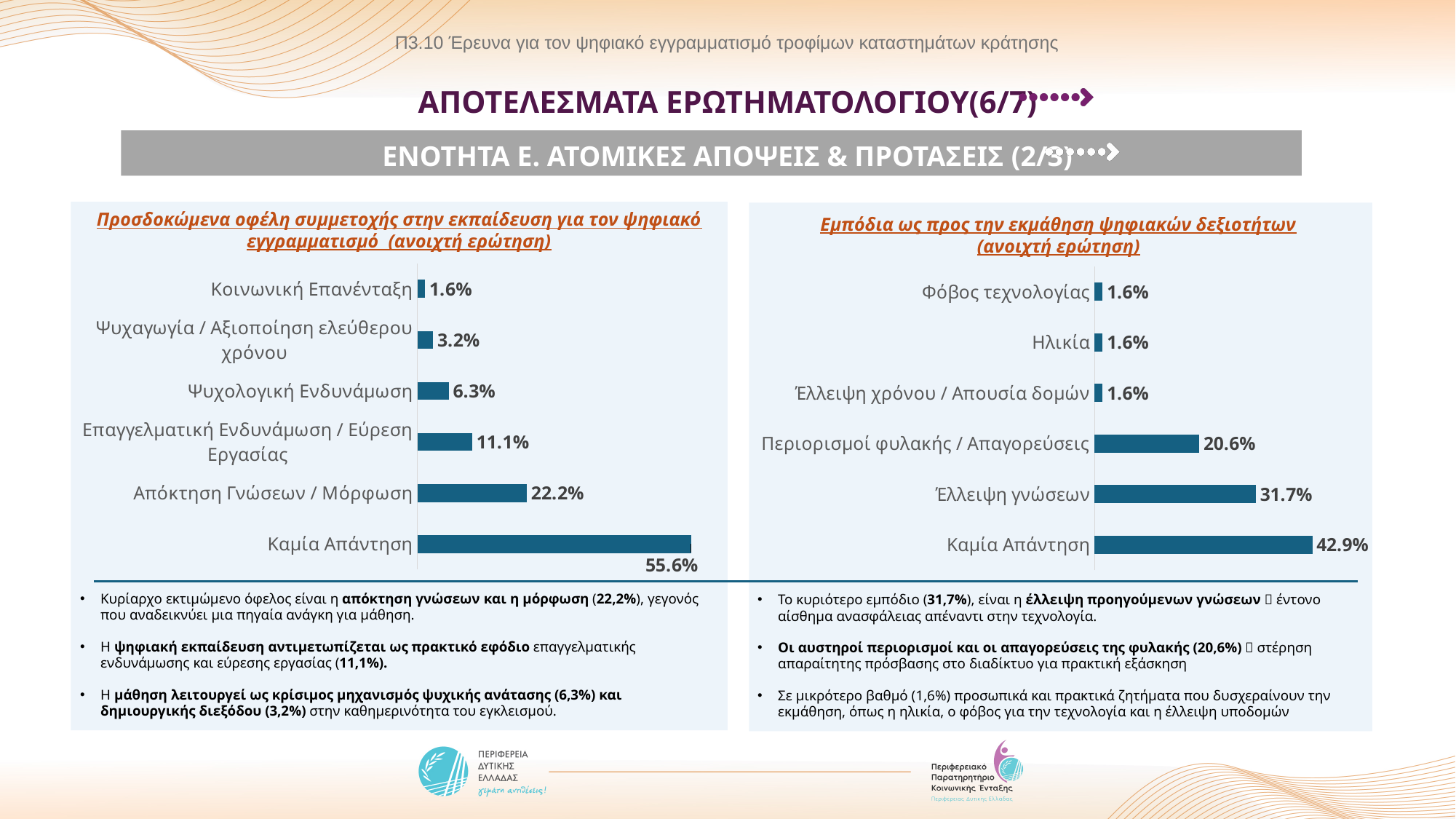
In the left chart (Προσδοκώμενα οφέλη συμμετοχής στην εκπαίδευση), what is the difference between Απόκτηση Γνώσεων / Μόρφωση and Ψυχολογική Ενδυνάμωση? 15.9% In the left chart (Προσδοκώμενα οφέλη συμμετοχής στην εκπαίδευση), what is the value for Απόκτηση Γνώσεων / Μόρφωση? 22.2% In the right chart (Εμπόδια ως προς την εκμάθηση ψηφιακών δεξιοτήτων), which category has the highest value? Καμία Απάντηση In the left chart (Προσδοκώμενα οφέλη συμμετοχής στην εκπαίδευση), which category has the lowest value? Κοινωνική Επανένταξη In the right chart (Εμπόδια ως προς την εκμάθηση ψηφιακών δεξιοτήτων), what is the value for Έλλειψη γνώσεων? 31.7% In the left chart (Προσδοκώμενα οφέλη συμμετοχής στην εκπαίδευση), how many categories are shown? 6 What type of chart is the right chart (Εμπόδια ως προς την εκμάθηση ψηφιακών δεξιοτήτων)? Bar chart In the right chart (Εμπόδια ως προς την εκμάθηση ψηφιακών δεξιοτήτων), what is the value for Περιορισμοί φυλακής / Απαγορεύσεις? 20.6% In the right chart (Εμπόδια ως προς την εκμάθηση ψηφιακών δεξιοτήτων), what is the difference between Καμία Απάντηση and Έλλειψη γνώσεων? 11.2% In the left chart (Προσδοκώμενα οφέλη συμμετοχής στην εκπαίδευση), what is the value for Επαγγελματική Ενδυνάμωση / Εύρεση Εργασίας? 11.1% In the left chart (Προσδοκώμενα οφέλη συμμετοχής στην εκπαίδευση), which category has the highest value? Καμία Απάντηση In the right chart (Εμπόδια ως προς την εκμάθηση ψηφιακών δεξιοτήτων), which is larger: Έλλειψη γνώσεων or Περιορισμοί φυλακής / Απαγορεύσεις? Έλλειψη γνώσεων